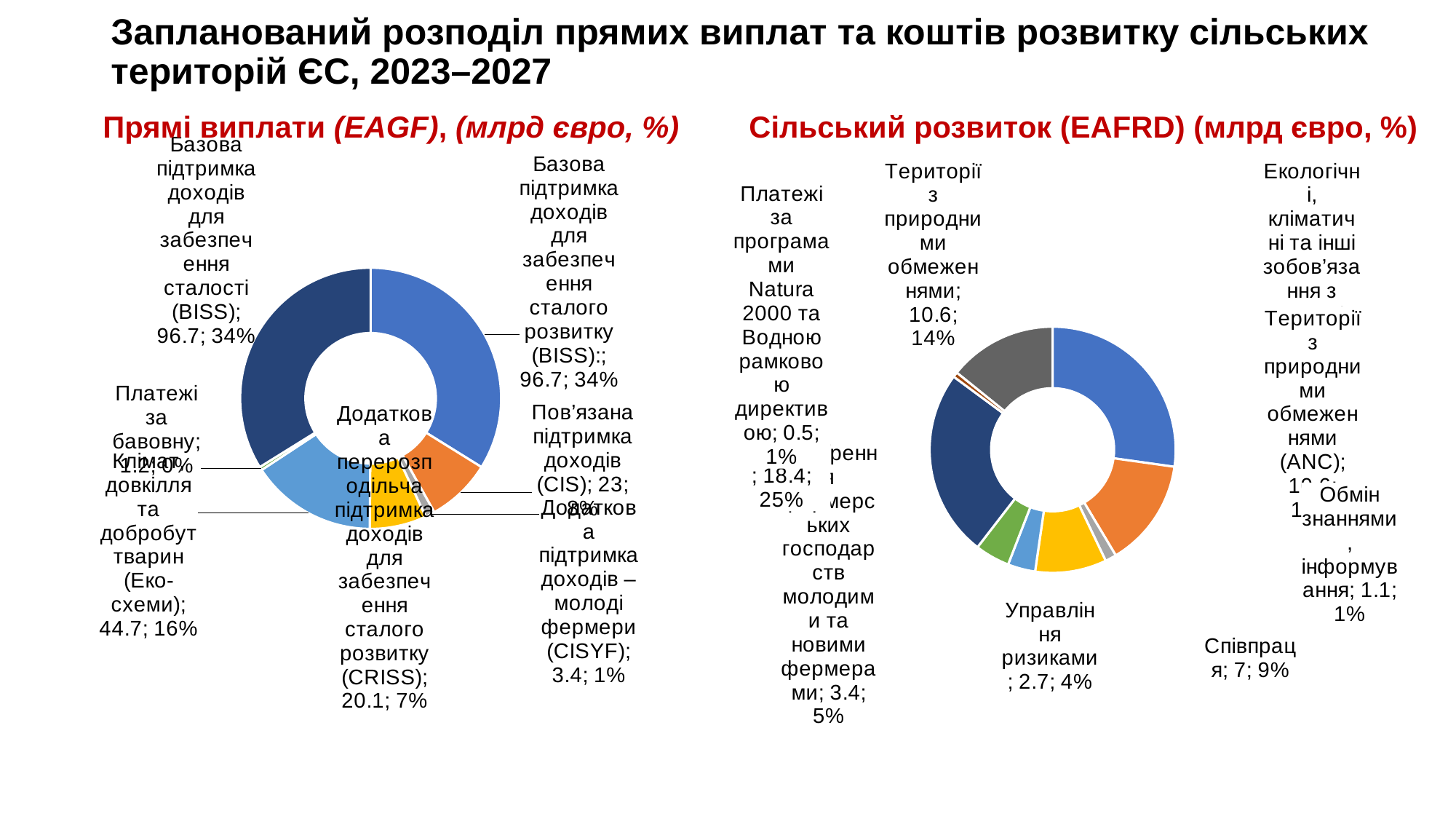
What kind of chart is the left chart titled "Прямі виплати (EAGF)"? Doughnut (pie) chart In the left chart "Прямі виплати (EAGF)", what value is shown for "Клімат, довкілля та добробут тварин (Еко-схеми)"? 44.7; 16% In the left chart "Прямі виплати (EAGF)", what is the difference in billion euro between CIS (23) and CRISS (20.1)? 2.9 In the left chart "Прямі виплати (EAGF)", what value is shown for "Платежі за бавовну"? 1.2; 0% In the left chart "Прямі виплати (EAGF)", what value is shown for "Додаткова перерозподільча підтримка доходів (CRISS)"? 20.1; 7% In the left chart "Прямі виплати (EAGF)", which is larger: Еко-схеми or CRISS? Еко-схеми In the left chart "Прямі виплати (EAGF)", what share of the total does "Базова підтримка доходів для забезпечення сталості (BISS)" have? 34% In the right chart "Сільський розвиток (EAFRD)", what value is shown for "Співпраця"? 7; 9% In the right chart "Сільський розвиток (EAFRD)", what value is shown for "Обмін знаннями, інформування"? 1.1; 1% In the right chart "Сільський розвиток (EAFRD)", what value is shown for "Території з природними обмеженнями (ANC)"? 10.6; 14% In the left chart "Прямі виплати (EAGF)", what value is shown for "Пов’язана підтримка доходів (CIS)"? 23; 8% In the right chart "Сільський розвиток (EAFRD)", what value is shown for "Управління ризиками"? 2.7; 4%